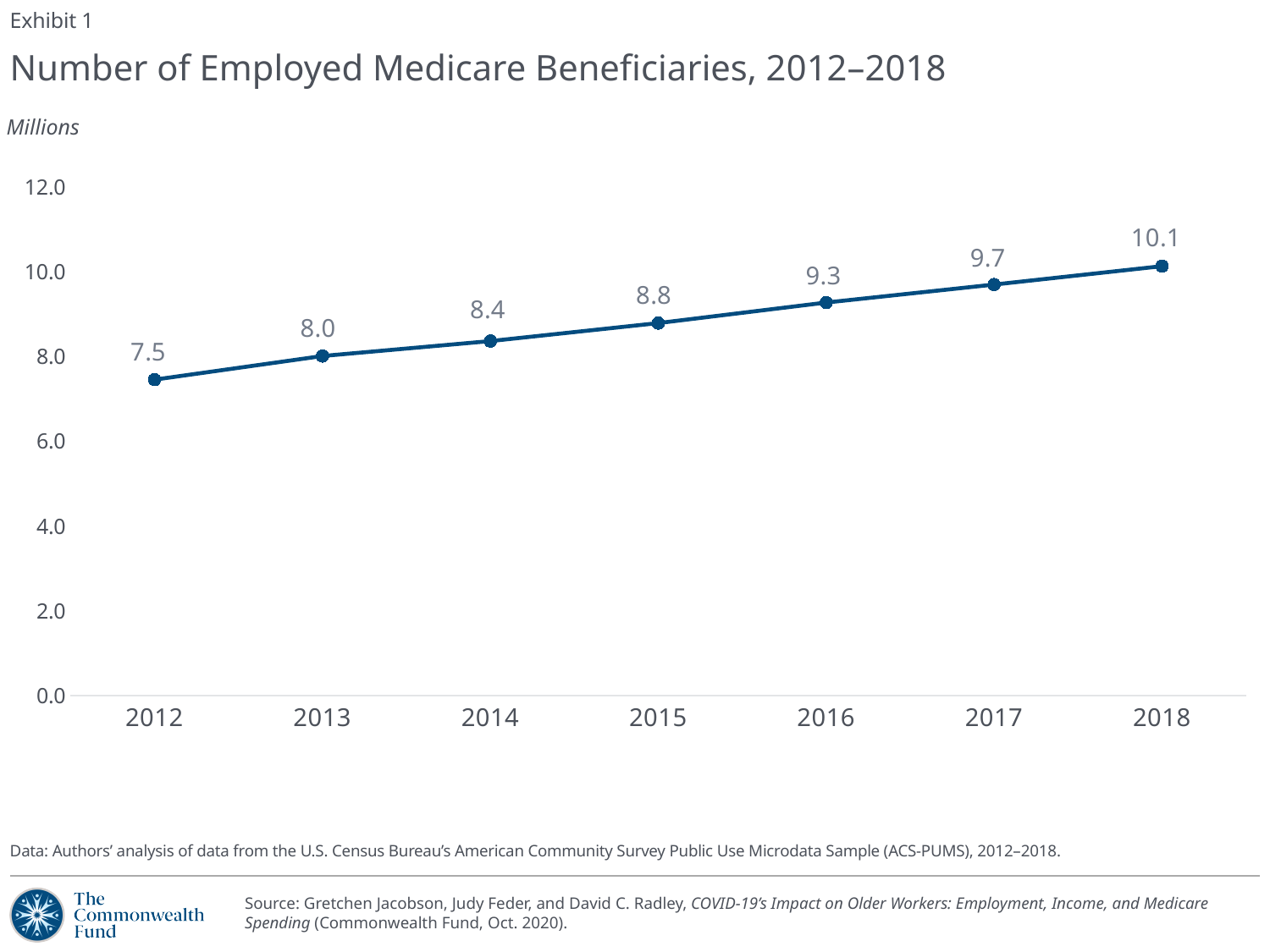
Is the value for 2017 greater or less than 10.0? less Which year has the lowest number of employed Medicare beneficiaries? 2012 Do the values rise or fall from 2012 to 2018? rise Which year has the highest number of employed Medicare beneficiaries? 2018 What is the difference in millions between the 2015 and 2014 values? 0.4 Which year has a larger value, 2013 or 2017? 2017 How many years are plotted on the chart? 7 By how many millions did the number of employed Medicare beneficiaries increase from 2012 to 2018? 2.6 What is the number of employed Medicare beneficiaries (in millions) in 2018? 10.1 What is the number of employed Medicare beneficiaries (in millions) in 2012? 7.5 What is the number of employed Medicare beneficiaries (in millions) in 2016? 9.3 What kind of chart is shown on the slide? line chart